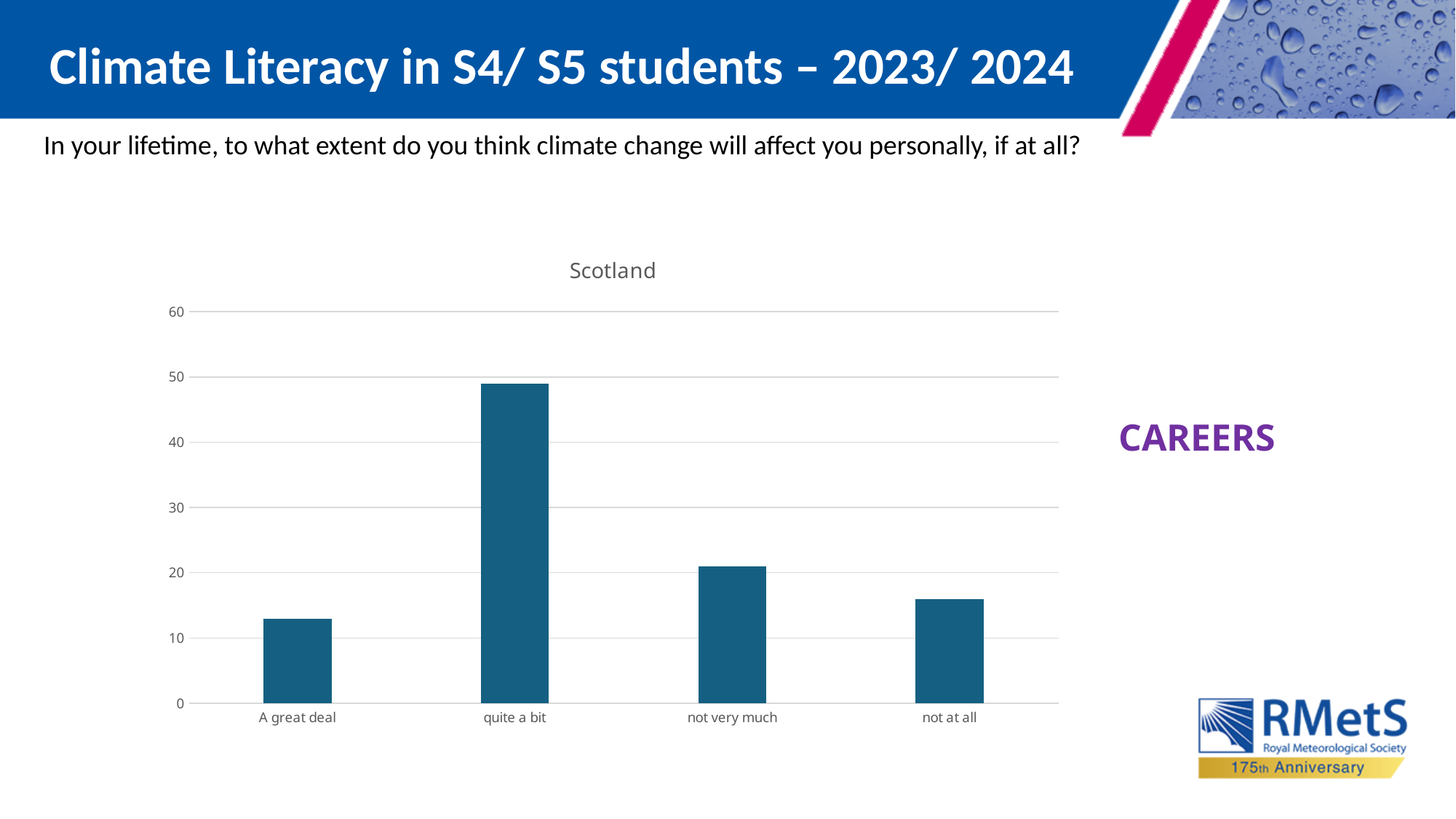
Is the value for 'not at all' greater or less than 10? greater Is the value for 'not at all' greater or less than 20? less What is the title of the chart? Scotland Which category has the lowest bar? A great deal Is the value for 'quite a bit' greater or less than 40? greater What is the highest value shown on the y axis of the chart? 60 What type of chart is shown on the slide? bar chart How many categories are shown on the x axis of the chart? 4 Which category has the highest bar? quite a bit Which is larger, the value for 'not very much' or the value for 'not at all'? not very much